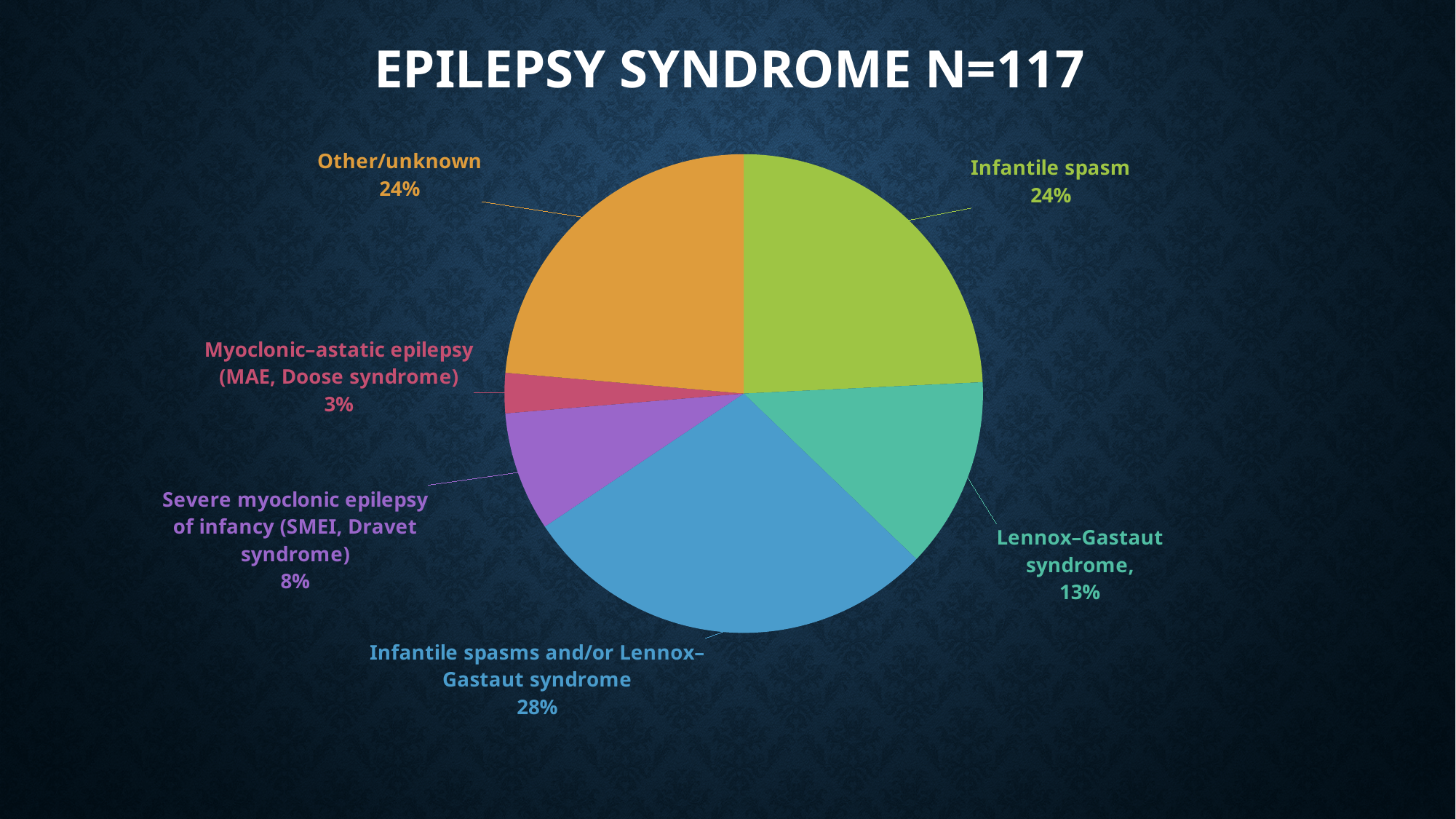
What share of the pie is Severe myoclonic epilepsy of infancy (SMEI, Dravet syndrome)? 8% What share of the pie is Infantile spasm? 24% What is the difference in percentage points between Infantile spasms and/or Lennox–Gastaut syndrome and Lennox–Gastaut syndrome? 15% What type of chart is shown on the slide? pie chart Which category has the largest slice of the pie? Infantile spasms and/or Lennox–Gastaut syndrome What share of the pie is Infantile spasms and/or Lennox–Gastaut syndrome? 28% How many categories are shown in the pie chart? 6 Which category has the smallest slice of the pie? Myoclonic–astatic epilepsy (MAE, Doose syndrome) Which is larger, the share for Severe myoclonic epilepsy of infancy (SMEI, Dravet syndrome) or the share for Lennox–Gastaut syndrome? Lennox–Gastaut syndrome What is the title of the chart? EPILEPSY SYNDROME N=117